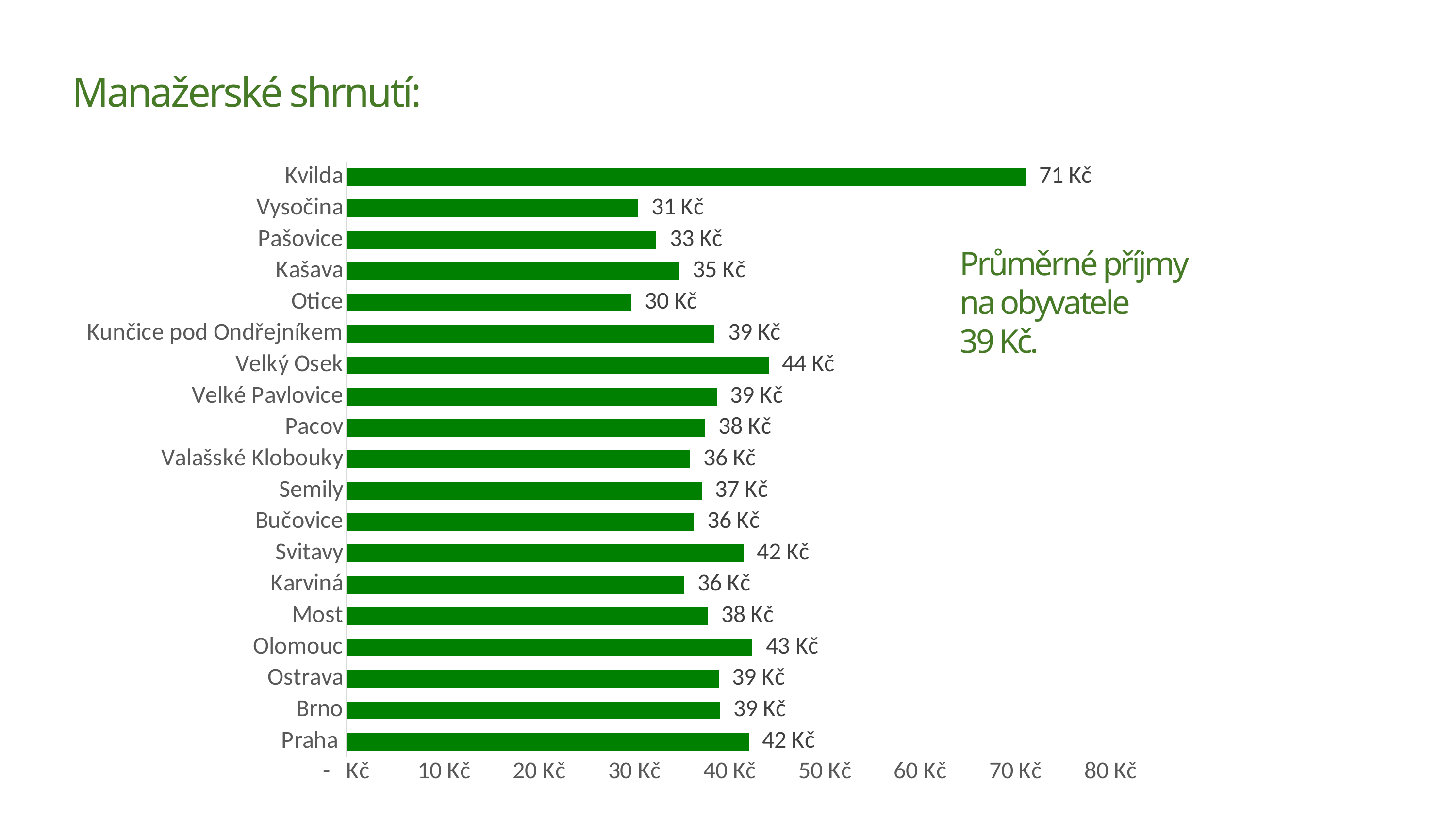
Which category has the lowest value? Otice Which is larger, the value for Velký Osek or the value for Olomouc? Velký Osek What is the difference between the values for Kvilda and Otice? 41 Kč What is the value for Kvilda? 71 Kč Is the value for Vysočina greater or less than 40 Kč? less What colour are the bars in the chart? green What is the value for Velký Osek? 44 Kč What kind of chart is shown on the slide? bar chart How many categories are shown in the chart? 19 What is the value for Kunčice pod Ondřejníkem? 39 Kč Which category has the highest value? Kvilda What is the value for Praha? 42 Kč